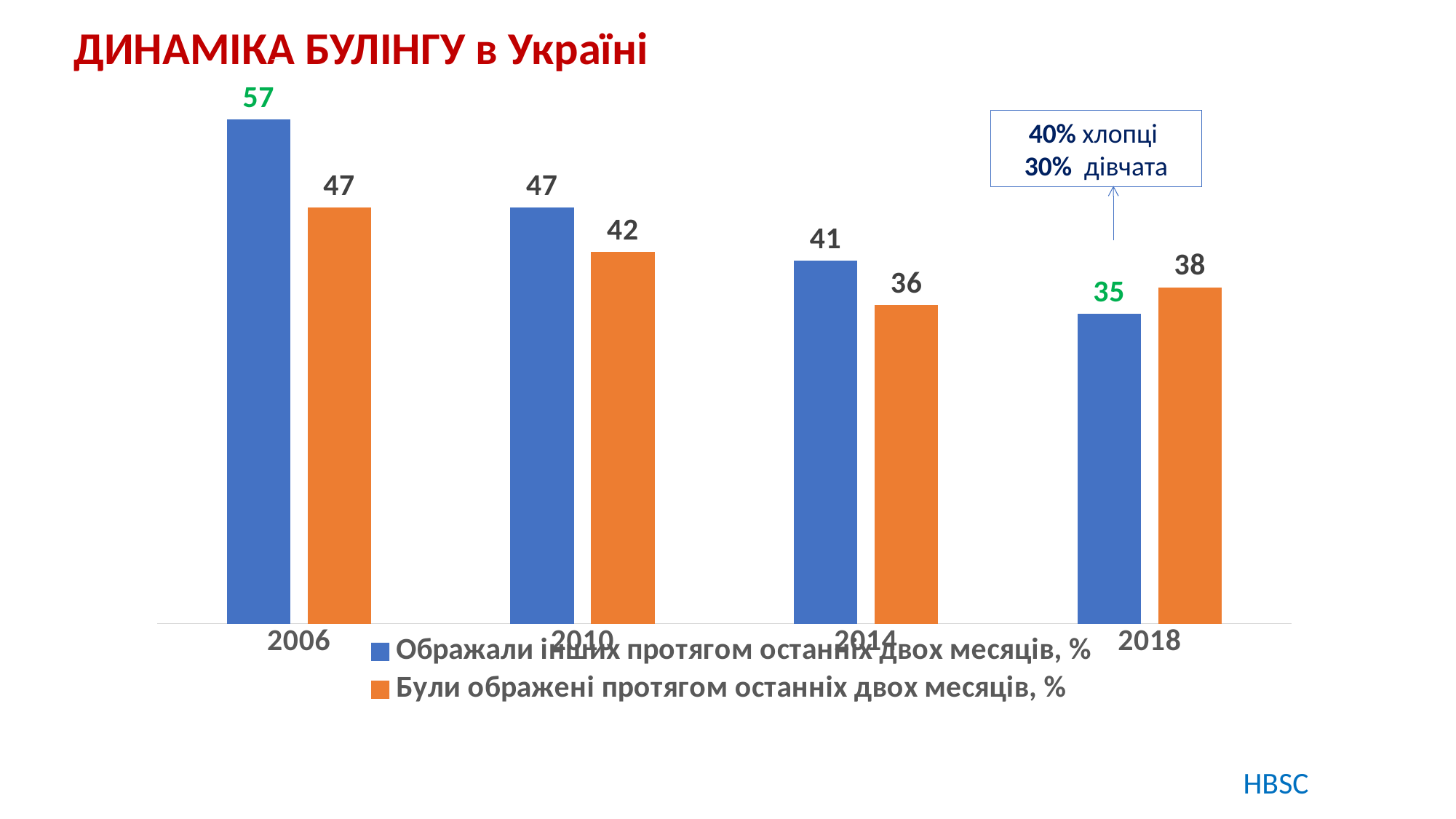
Which year has the highest value for 'Ображали інших протягом останніх двох месяців, %'? 2006 What kind of chart is shown on the slide? Bar chart How many years are shown on the x axis? 4 How many series does the legend list? 2 What is the value for 'Ображали інших протягом останніх двох месяців, %' in 2006? 57 What is the difference between the 2006 and 2018 values for 'Ображали інших протягом останніх двох месяців, %'? 22 What is the value for 'Були ображені протягом останніх двох месяців, %' in 2018? 38 What is the title of the slide? ДИНАМІКА БУЛІНГУ в Україні In 2018, which series has the larger value: 'Ображали інших' or 'Були ображені'? Були ображені протягом останніх двох месяців, % Does the value for 'Ображали інших протягом останніх двох месяців, %' rise or fall from 2006 to 2018? Fall What is the value for 'Ображали інших протягом останніх двох месяців, %' in 2014? 41 Which year has the lowest value for 'Були ображені протягом останніх двох месяців, %'? 2014